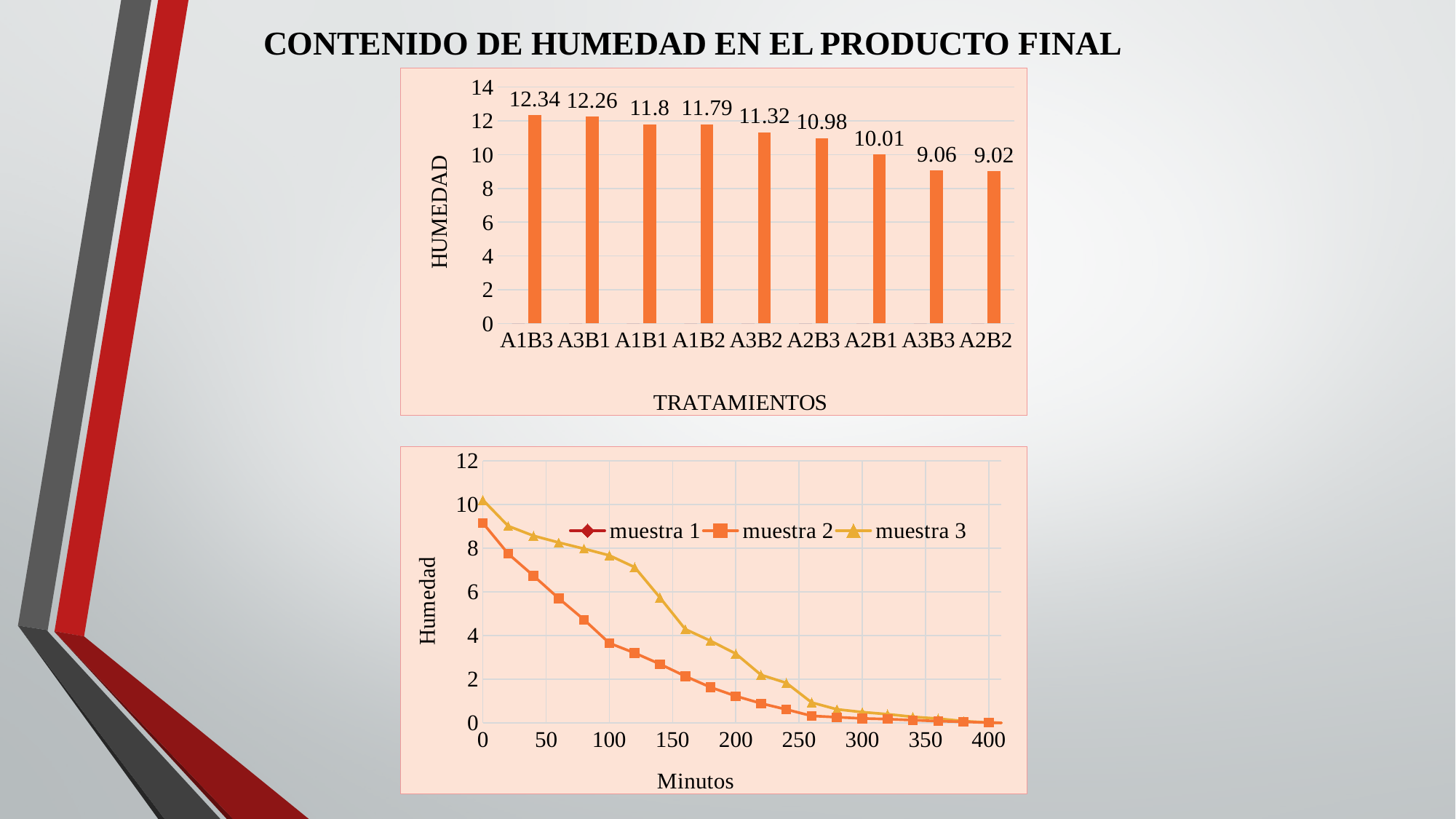
What type of chart is the top chart on the slide? bar chart In the top chart, which treatment has the highest humidity? A1B3 In the bottom chart, is the value for muestra 2 at 0 minutes greater or less than 8? greater In the top chart, what is the humidity value for treatment A2B1? 10.01 In the bottom chart, do the humidity values rise or fall as the minutes increase? fall How many series does the legend of the bottom chart list? 3 In the top chart, which has a higher humidity value, A3B2 or A2B3? A3B2 In the top chart (CONTENIDO DE HUMEDAD EN EL PRODUCTO FINAL), what is the humidity value for treatment A1B3? 12.34 How many treatments are shown in the top bar chart? 9 In the bottom chart, is the value for muestra 3 at 200 minutes greater or less than 4? less In the top chart, what is the difference between the humidity of A1B3 and A2B2? 3.32 In the top chart, which treatment has the lowest humidity? A2B2